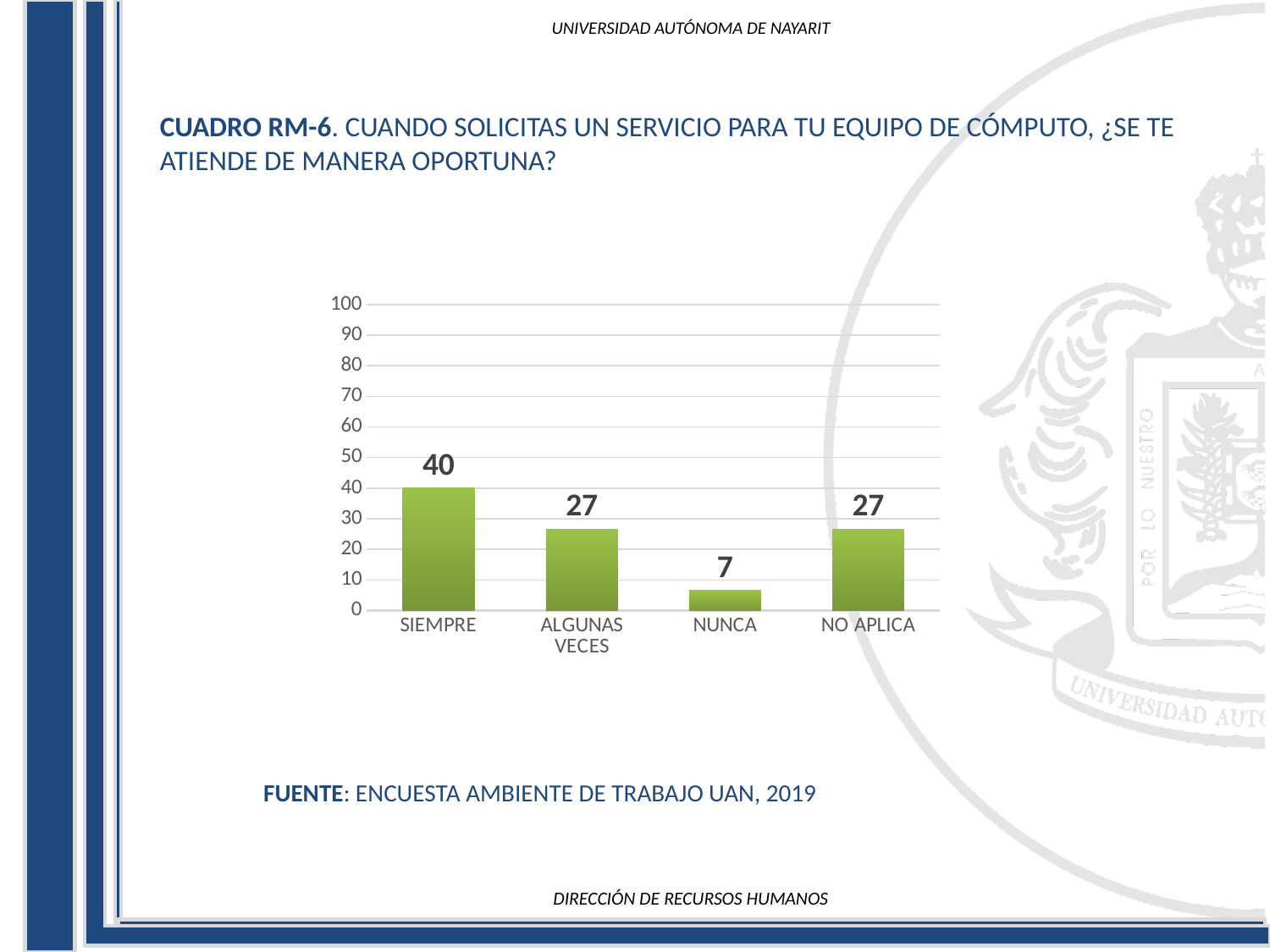
What is the value for ALGUNAS VECES? 27 What is the difference between the values for SIEMPRE and NUNCA? 33 What is the value for SIEMPRE? 40 Which is larger, the value for SIEMPRE or the value for NO APLICA? SIEMPRE What is the difference between the values for SIEMPRE and ALGUNAS VECES? 13 What is the value for NO APLICA? 27 How many categories are shown on the x axis? 4 Is the value for NUNCA greater or less than 10? less Which category has the lowest value? NUNCA What is the value for NUNCA? 7 What kind of chart is shown on the slide? bar chart Which category has the highest value? SIEMPRE